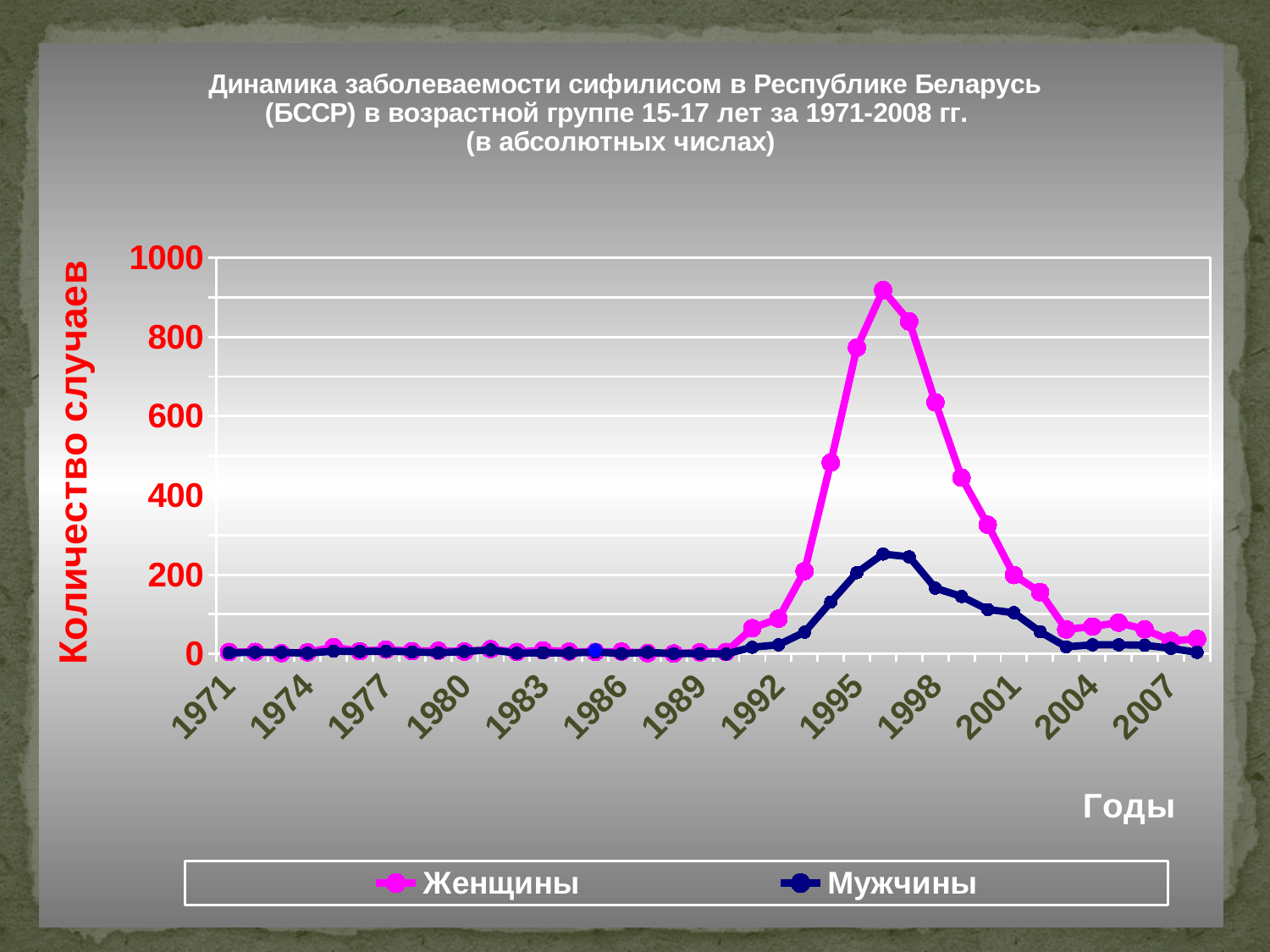
How many series does the legend list? 2 What kind of chart is shown on the slide? line chart Do the values for Женщины rise or fall between the mid-1990s peak and 2004? fall Which series reaches the highest value on the chart? Женщины How many year labels are printed along the x axis? 13 Do the values for Женщины rise or fall between 1989 and the mid-1990s peak? rise What are the two series named in the legend? Женщины and Мужчины Is the peak value of the Женщины series greater or less than 800? greater Is the peak value of the Мужчины series greater or less than 400? less Is the value for Женщины in 1971 greater or less than 200? less What is the title of the vertical axis? Количество случаев At the peak of the chart in the mid-1990s, which series has the larger value, Женщины or Мужчины? Женщины